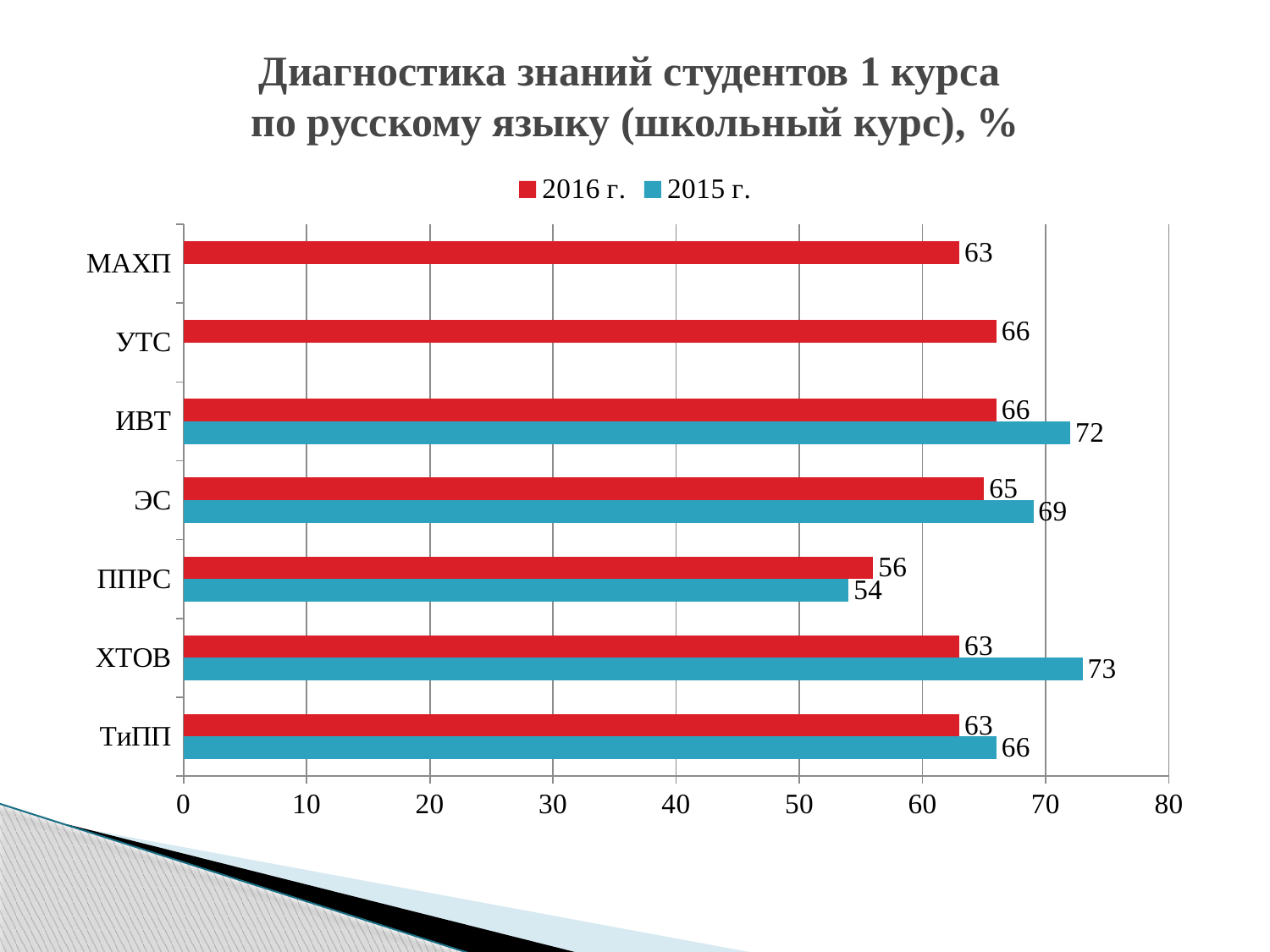
Which category has the highest value in the 2015 г. series? ХТОВ Is the value for ХТОВ in the 2015 г. series greater or less than 70? greater How many categories are shown on the y axis of the chart? 7 What is the difference between the 2015 г. and 2016 г. values for ХТОВ? 10 For ЭС, which series has the larger value, 2016 г. or 2015 г.? 2015 г. What kind of chart is shown on the slide? bar chart What is the value for ИВТ in the 2015 г. series? 72 Which category has the lowest value in the 2016 г. series? ППРС What is the value for ППРС in the 2016 г. series? 56 For ППРС, which series has the larger value, 2016 г. or 2015 г.? 2016 г. How many series does the legend list? 2 What is the value for МАХП in the 2016 г. series? 63